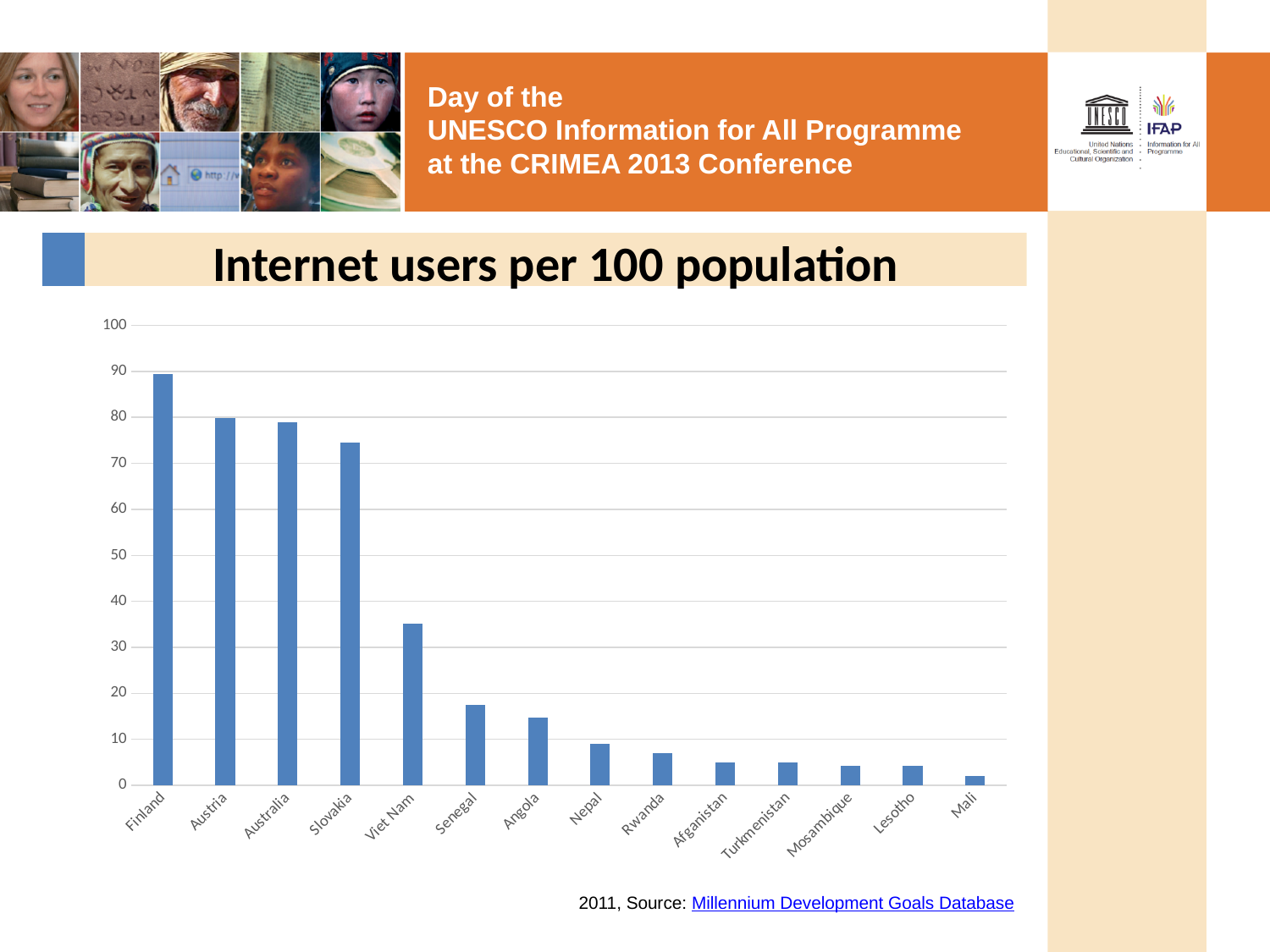
Is the value for Viet Nam greater or less than 30? greater What is the title of the chart? Internet users per 100 population Which has a higher value, Viet Nam or Senegal? Viet Nam What kind of chart is shown on the slide? bar chart Is the value for Finland greater or less than 80? greater Do the values rise or fall moving from left to right along the x axis? fall Which has a higher value, Finland or Slovakia? Finland Is the value for Senegal greater or less than 20? less Which country has the lowest number of internet users per 100 population? Mali Which country has the highest number of internet users per 100 population? Finland How many countries are shown on the x axis of the chart? 14